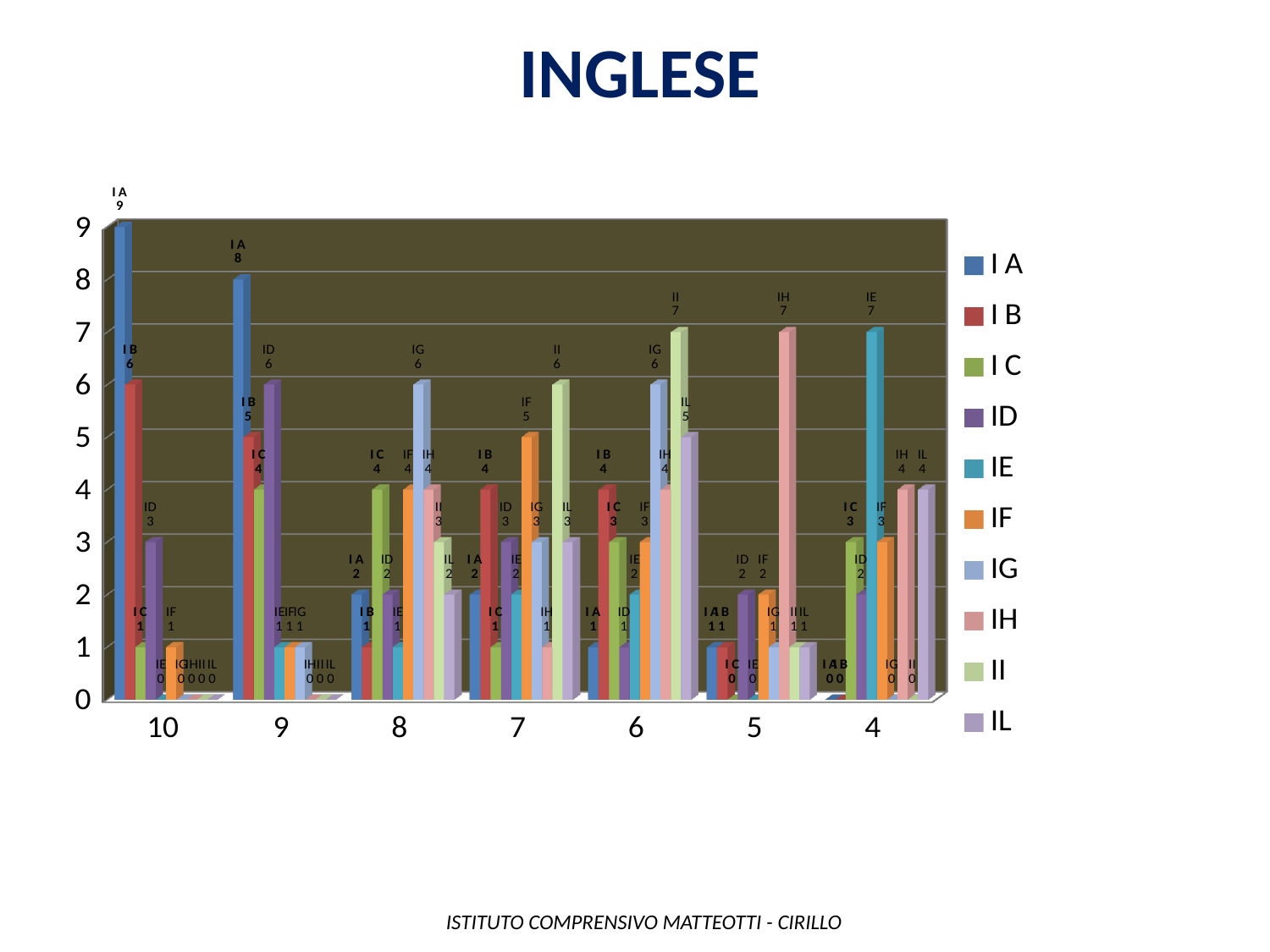
What is the title of the chart? INGLESE What is the difference between the values of I A and I B in category 10? 3 What is the value for series IE in category 4? 7 How many series does the legend list? 10 What is the value for series ID in category 9? 6 In which category does series I A reach its highest value? 10 What is the value for series IH in category 5? 7 What is the value for series II in category 6? 7 How many categories are shown on the x axis? 7 What kind of chart is shown on the slide? bar chart What is the value for series I A in category 10? 9 In category 8, which is larger: the value for IG or the value for IF? IG